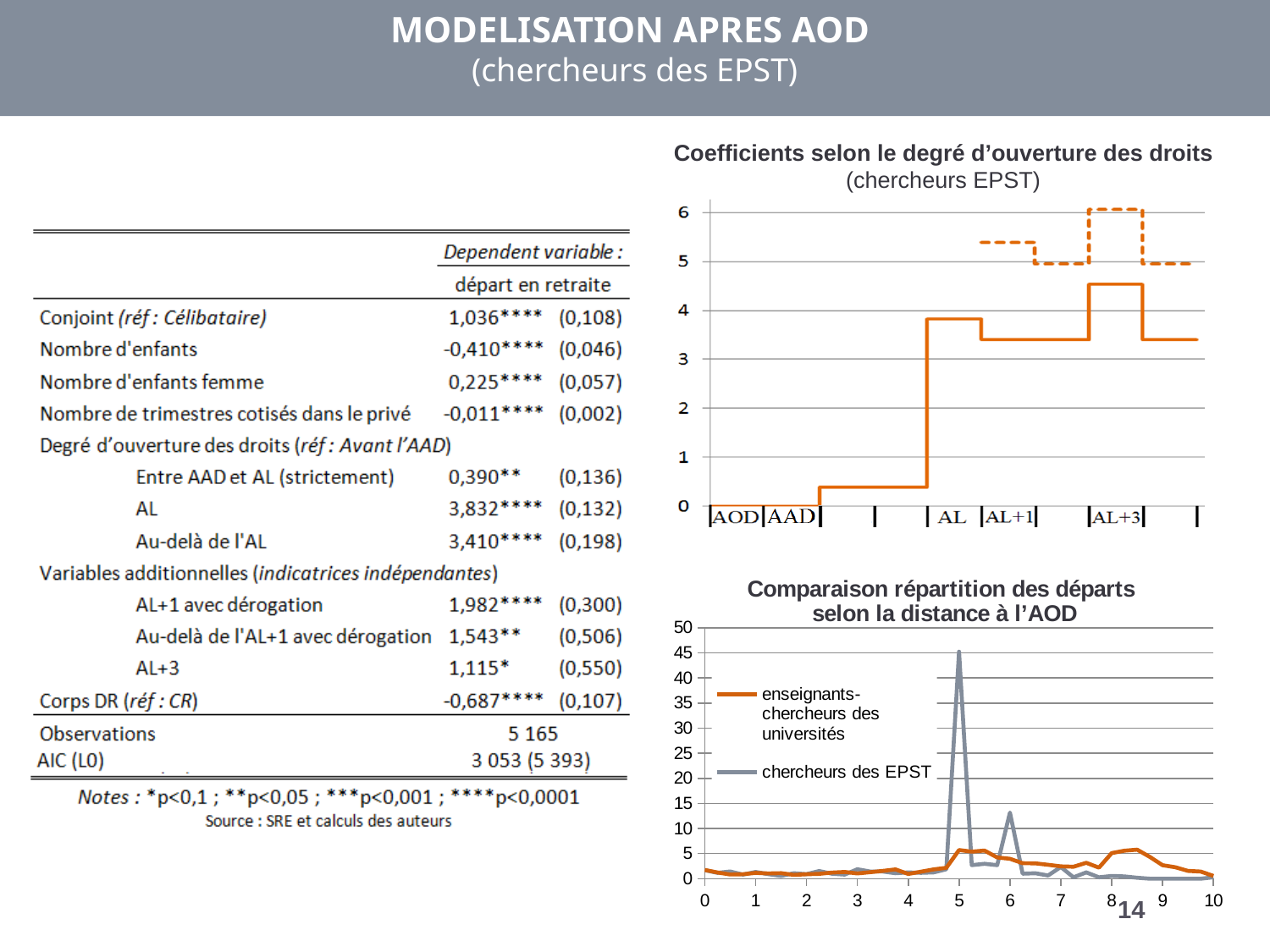
In the bottom chart 'Comparaison répartition des départs selon la distance à l'AOD', is the peak value of 'chercheurs des EPST' at x = 5 greater or less than 40? greater In the bottom chart 'Comparaison répartition des départs selon la distance à l'AOD', at x = 5 which series has the larger value, 'chercheurs des EPST' or 'enseignants-chercheurs des universités'? chercheurs des EPST In the top chart 'Coefficients selon le degré d'ouverture des droits', is the value of the solid line at 'AL' greater or less than 3? greater In the top chart 'Coefficients selon le degré d'ouverture des droits', is the value of the solid line at 'AOD' greater or less than 1? less What is the subtitle shown in parentheses under the title of the top chart 'Coefficients selon le degré d'ouverture des droits'? (chercheurs EPST) In the bottom chart 'Comparaison répartition des départs selon la distance à l'AOD', which series reaches the highest peak? chercheurs des EPST How many series does the legend of the bottom chart 'Comparaison répartition des départs selon la distance à l'AOD' list? 2 What kind of chart is the bottom chart titled 'Comparaison répartition des départs selon la distance à l'AOD'? line chart In the bottom chart 'Comparaison répartition des départs selon la distance à l'AOD', what colour is the line for 'chercheurs des EPST'? grey In the top chart 'Coefficients selon le degré d'ouverture des droits', does the solid line generally rise or fall from 'AOD' to 'AL+3'? rise